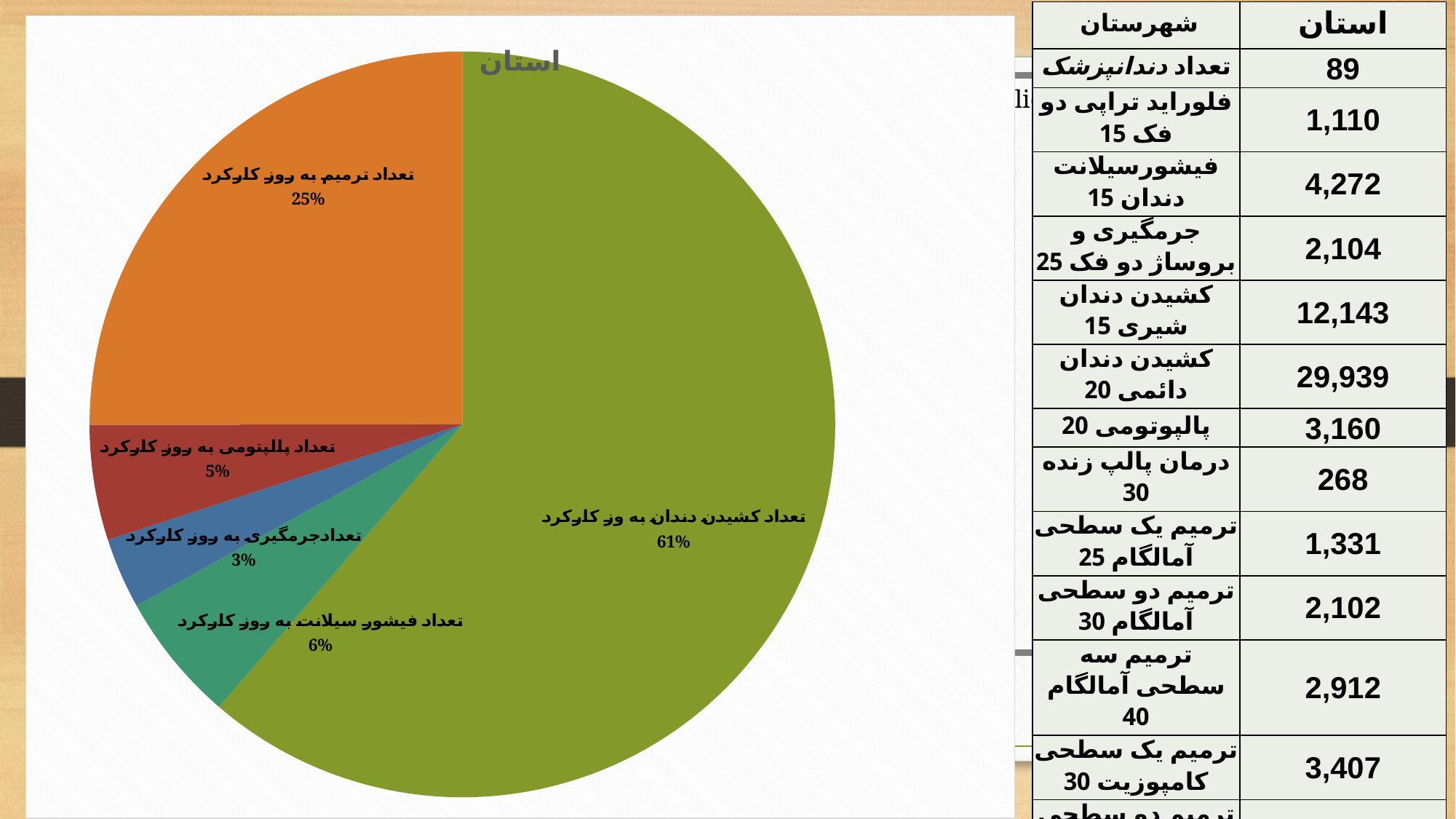
What kind of chart is shown on the slide? pie chart What share of the pie does تعداد ترمیم به روز کارکرد represent? 25% What is the title of the pie chart? استان How many slices does the pie chart have? 5 What share of the pie does تعداد فیشور سیلانت به روز کارکرد represent? 6% Which slice of the pie chart is the largest? تعداد کشیدن دندان به روز کارکرد What share of the pie does تعداد جرمگیری به روز کارکرد represent? 3% What is the difference in percentage points between تعداد کشیدن دندان به روز کارکرد and تعداد ترمیم به روز کارکرد? 36 Which is larger, the share for تعداد فیشور سیلانت به روز کارکرد or the share for تعداد پالپوتومی به روز کارکرد? تعداد فیشور سیلانت به روز کارکرد Which slice of the pie chart is the smallest? تعداد جرمگیری به روز کارکرد